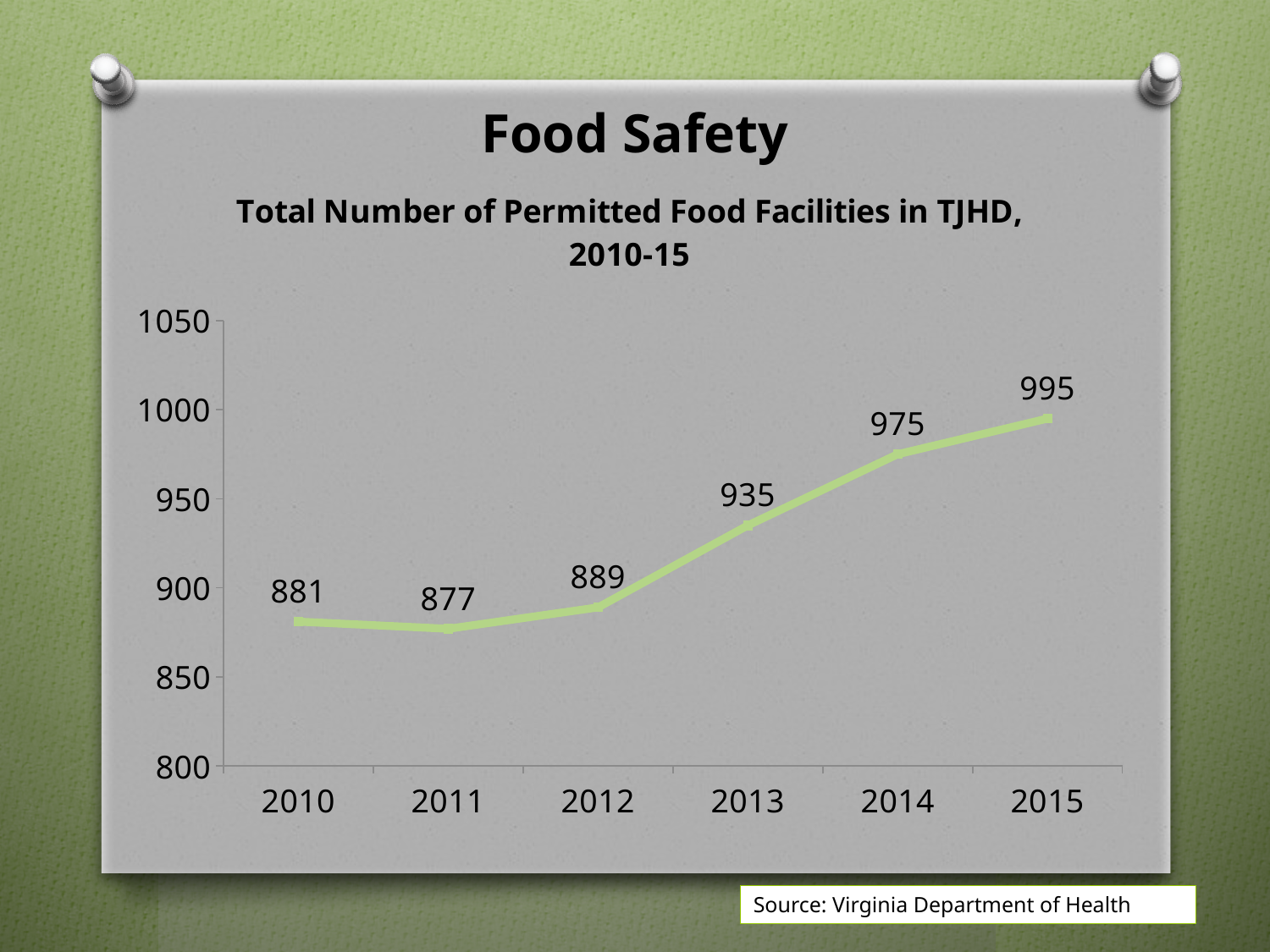
What is the value shown for 2015? 995 By how much did the number of permitted food facilities increase from 2013 to 2014? 40 What is the total number of permitted food facilities in TJHD in 2013? 935 Which year has a larger value, 2012 or 2014? 2014 What is the difference between the values for 2015 and 2010? 114 What is the title of the chart? Total Number of Permitted Food Facilities in TJHD, 2010-15 Which year has the lowest number of permitted food facilities? 2011 How many years are plotted on the chart? 6 Is the value for 2014 greater or less than 950? greater What kind of chart is shown on the slide? Line chart Which year has the highest number of permitted food facilities? 2015 What is the value shown for 2010? 881